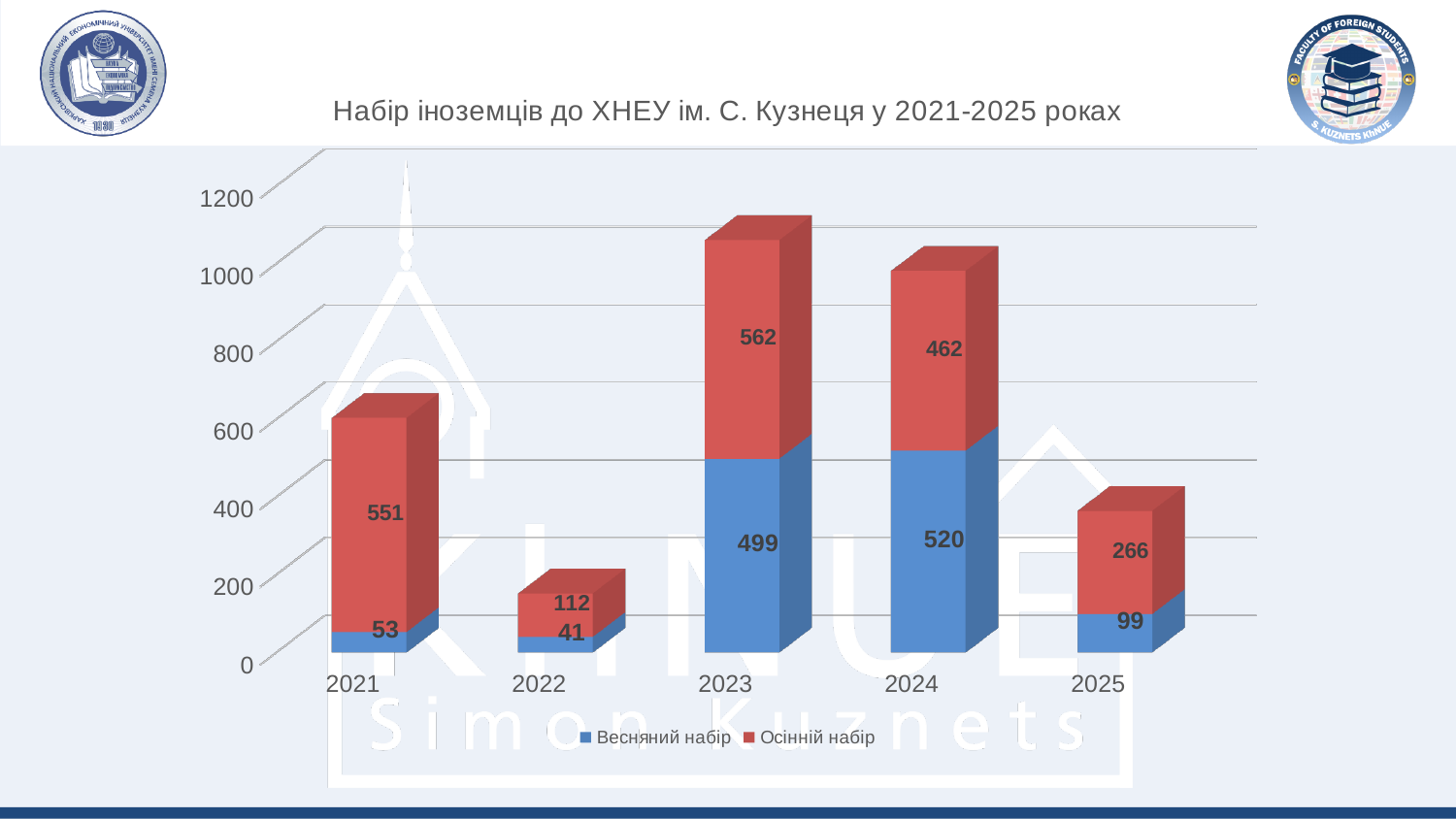
What is the value of Весняний набір for 2023? 499 How many series does the legend list? 2 What is the total of the stacked bar for 2023? 1061 How many years are shown on the x axis? 5 What is the value of Весняний набір for 2025? 99 Which year has the lowest value for Весняний набір? 2022 Which year has the highest value for Осінній набір? 2023 What is the total of the stacked bar for 2021? 604 Which is larger: Весняний набір in 2024 or Весняний набір in 2023? Весняний набір in 2024 What kind of chart is shown on the slide? Stacked bar chart What is the difference between Осінній набір in 2023 and Осінній набір in 2024? 100 What is the value of Осінній набір for 2021? 551